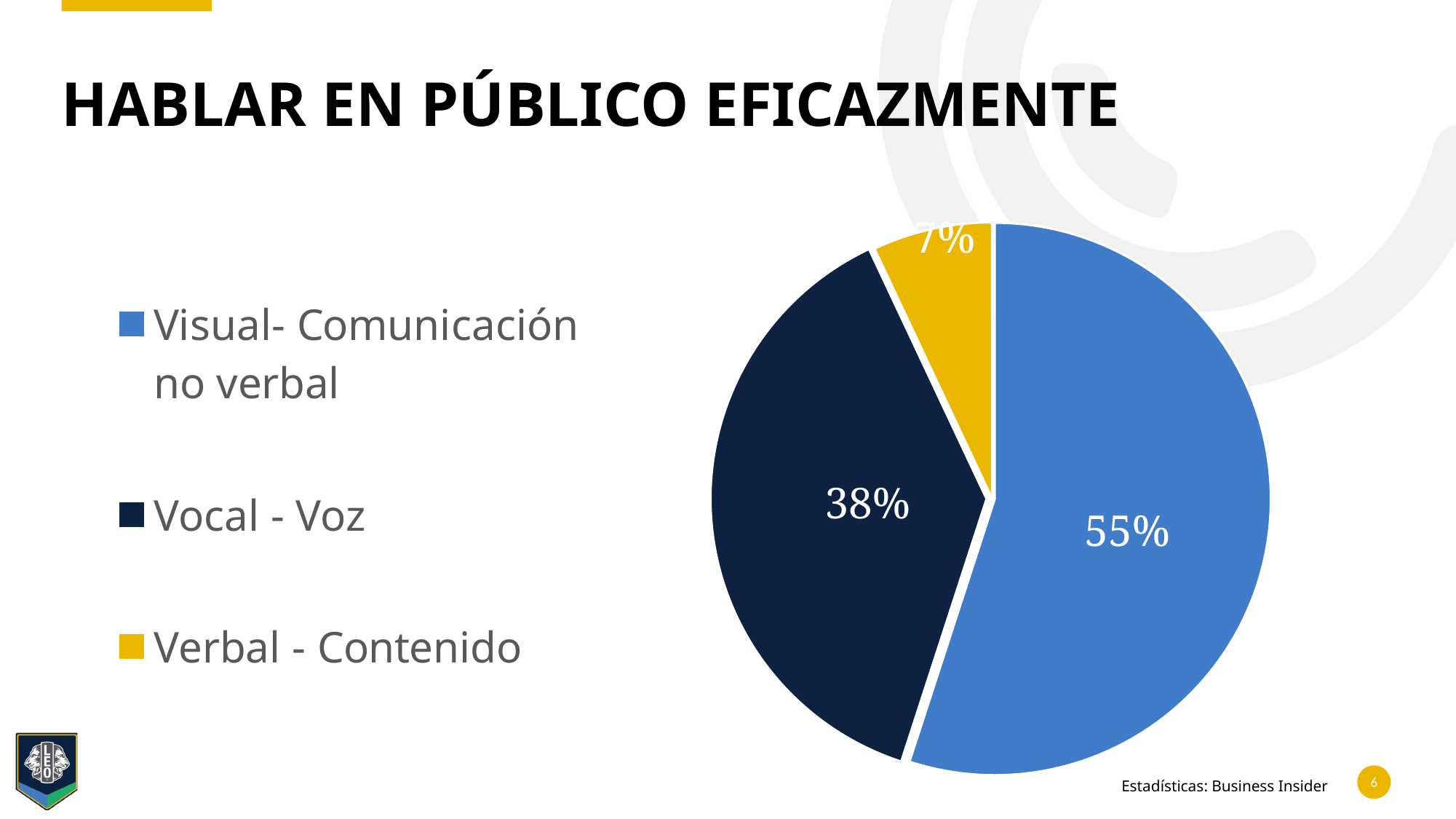
How many slices does the pie chart have? 3 What is the difference in percentage points between Vocal - Voz and Verbal - Contenido? 31 Which category has the largest slice of the pie? Visual- Comunicación no verbal What colour is the slice for Verbal - Contenido? yellow What kind of chart is shown on the slide? pie chart How many entries does the legend list? 3 Which is larger, the slice for Vocal - Voz or the slice for Verbal - Contenido? Vocal - Voz What is the difference in percentage points between Visual- Comunicación no verbal and Vocal - Voz? 17 What share of the pie does Verbal - Contenido have? 7% What share of the pie does Vocal - Voz have? 38% What share of the pie does Visual- Comunicación no verbal have? 55% Which category has the smallest slice of the pie? Verbal - Contenido